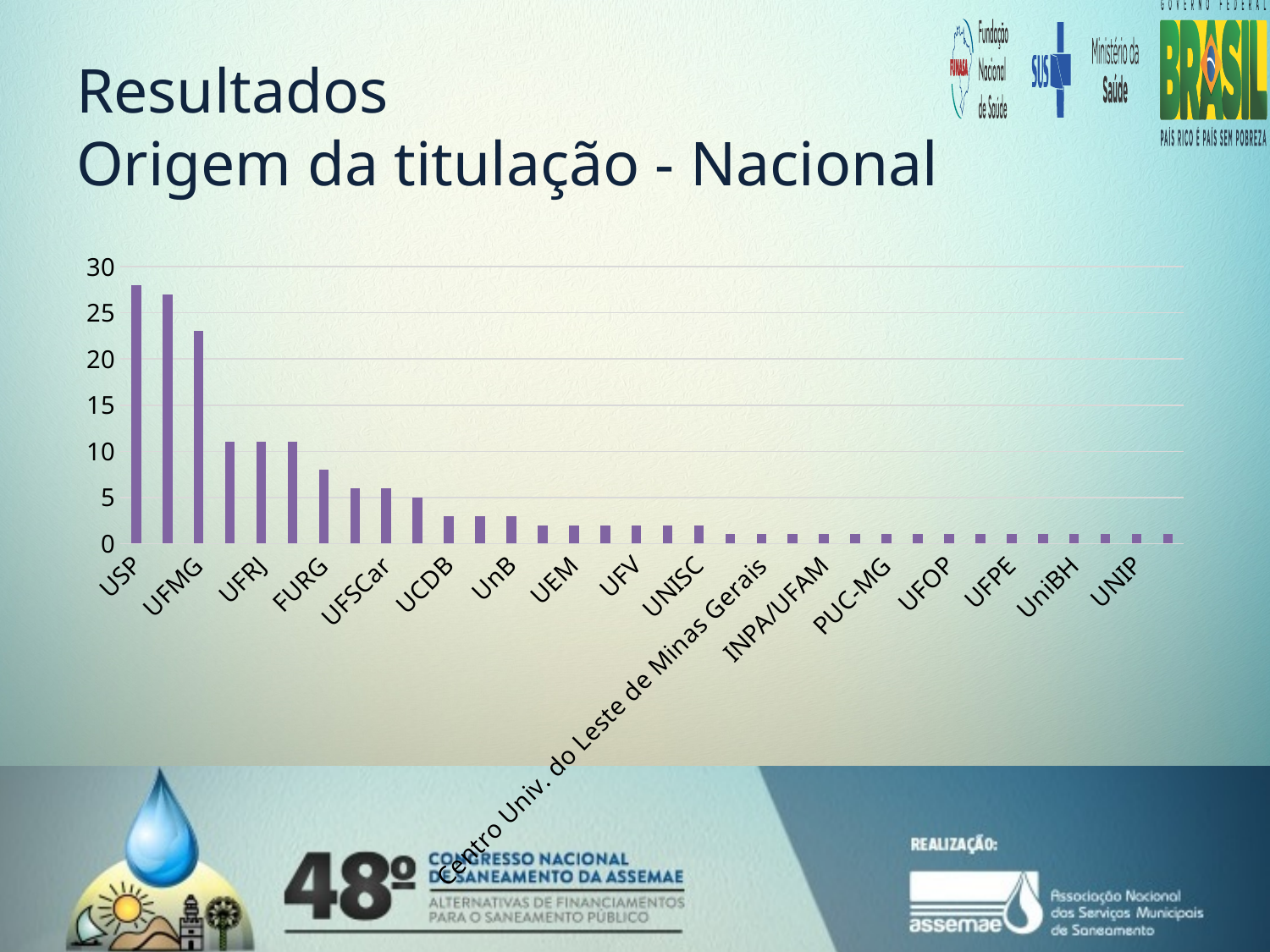
Is the value for UFSCar greater or less than 10? less Which category has the highest value in the chart? USP What kind of chart is shown on the slide? bar chart What is the title of the slide containing the chart? Resultados Origem da titulação - Nacional Is the value for UCDB greater or less than 10? less Do the values generally rise or fall from left to right along the x axis? fall Which has a larger value, USP or UNIP? USP Is the value for UNIP greater or less than 5? less Which has a larger value, UFMG or UFRJ? UFMG